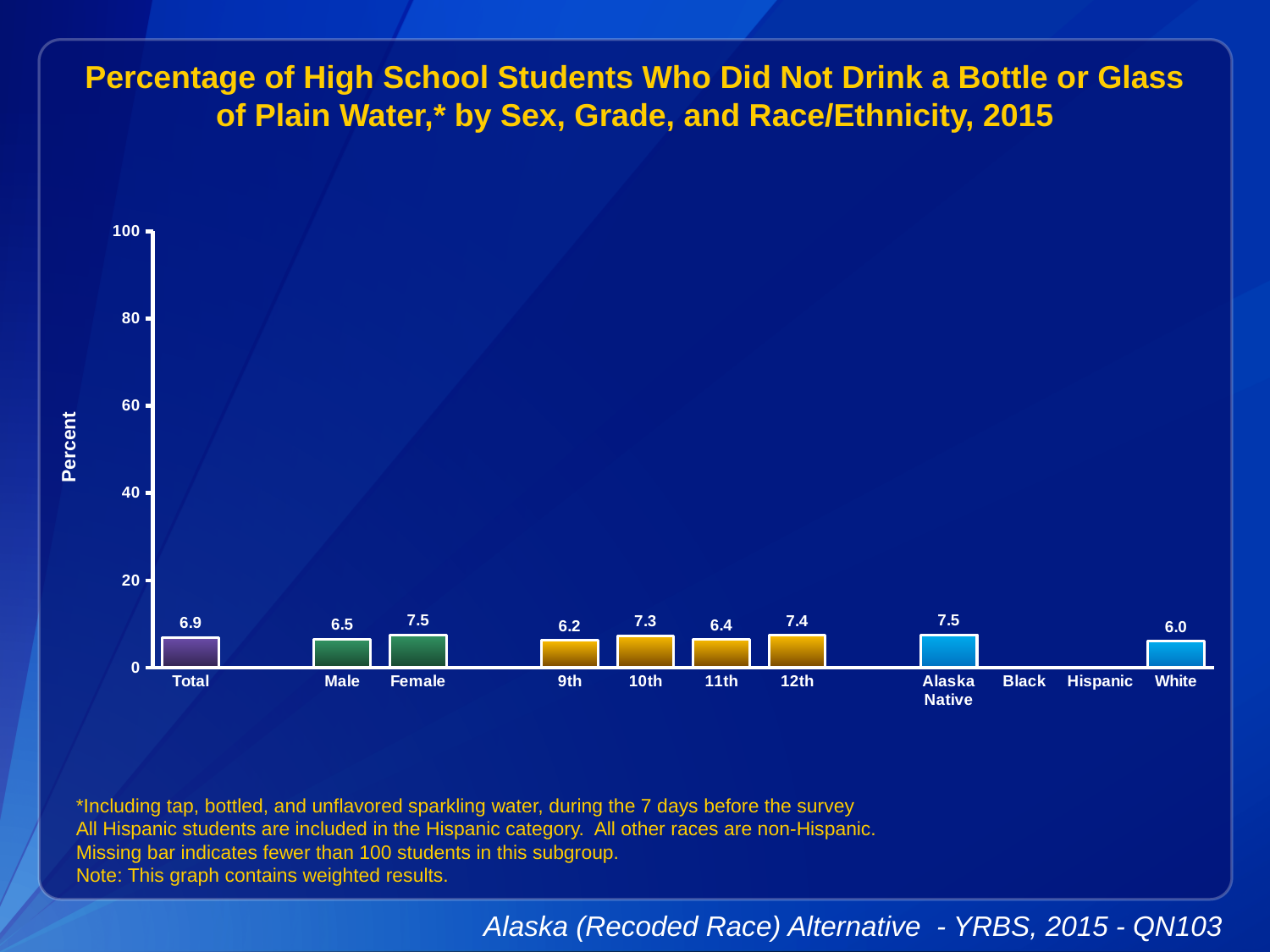
Which category has the lowest value among all bars shown? White Is the value for Alaska Native greater or less than 20? less What is the difference between the 12th grade and 9th grade values? 1.2 Which grade has the lowest value? 9th What is the value for 9th grade? 6.2 What is the value for Total? 6.9 What is the difference between the Female and Male values? 1.0 What is the value for White? 6.0 What is the value for Female? 7.5 What kind of chart is shown on the slide? bar chart How many categories have a bar plotted? 9 Which is larger, the value for 10th grade or 11th grade? 10th